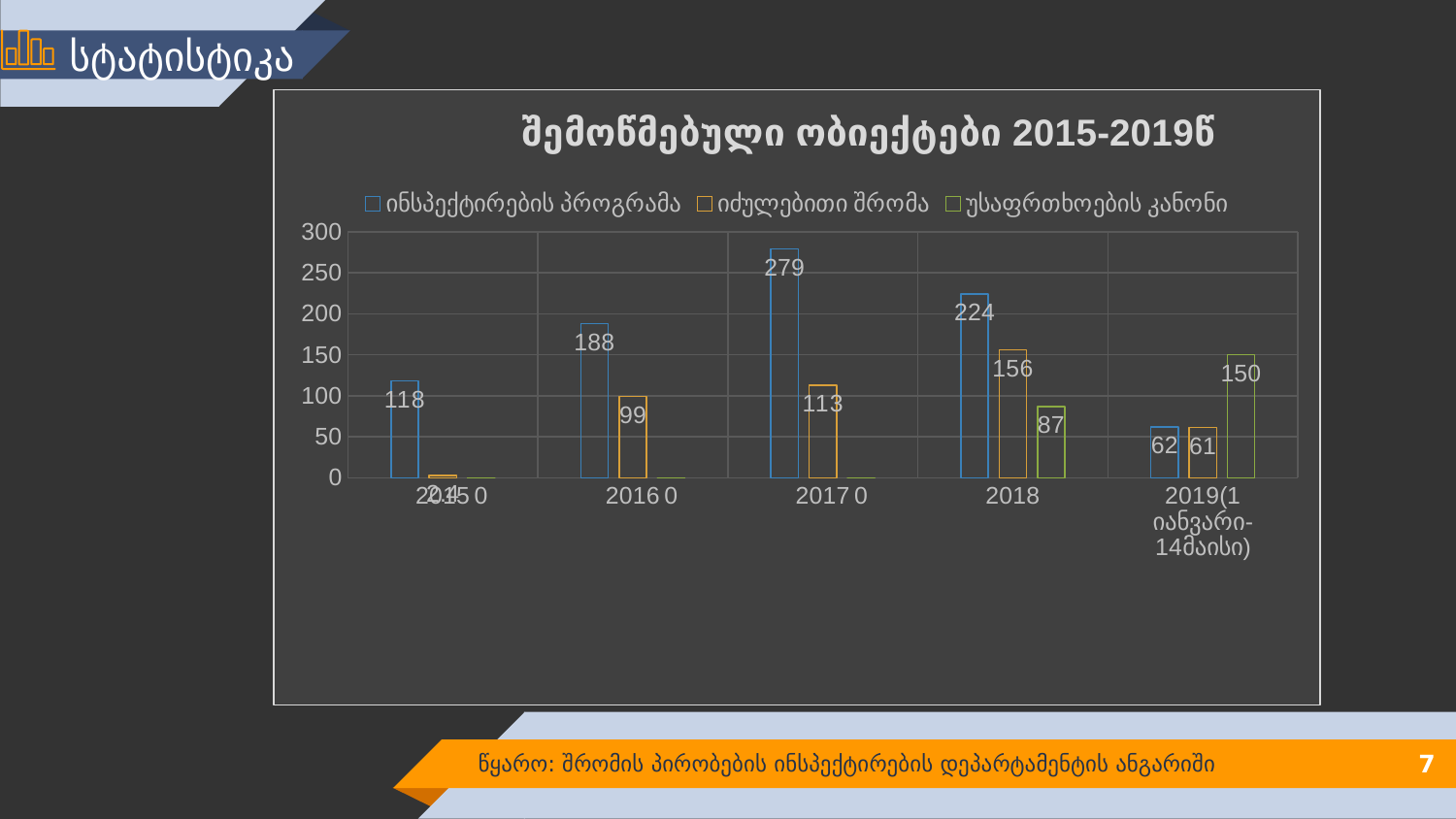
What is the title of the chart? შემოწმებული ობიექტები 2015-2019წ Which is larger in 2019(1 იანვარი-14მაისი): ინსპექტირების პროგრამა or უსაფრთხოების კანონი? უსაფრთხოების კანონი What type of chart is shown on the slide? bar chart In which year is the value for ინსპექტირების პროგრამა highest? 2017 In which year is the value for ინსპექტირების პროგრამა lowest? 2019(1 იანვარი-14მაისი) What is the value for უსაფრთხოების კანონი in 2019(1 იანვარი-14მაისი)? 150 What is the value for ინსპექტირების პროგრამა in 2017? 279 How many series does the legend list? 3 What is the difference between ინსპექტირების პროგრამა in 2017 and in 2018? 55 How many year categories are shown on the x axis? 5 Is the value for ინსპექტირების პროგრამა in 2016 greater or less than 150? greater What is the value for იძულებითი შრომა in 2018? 156